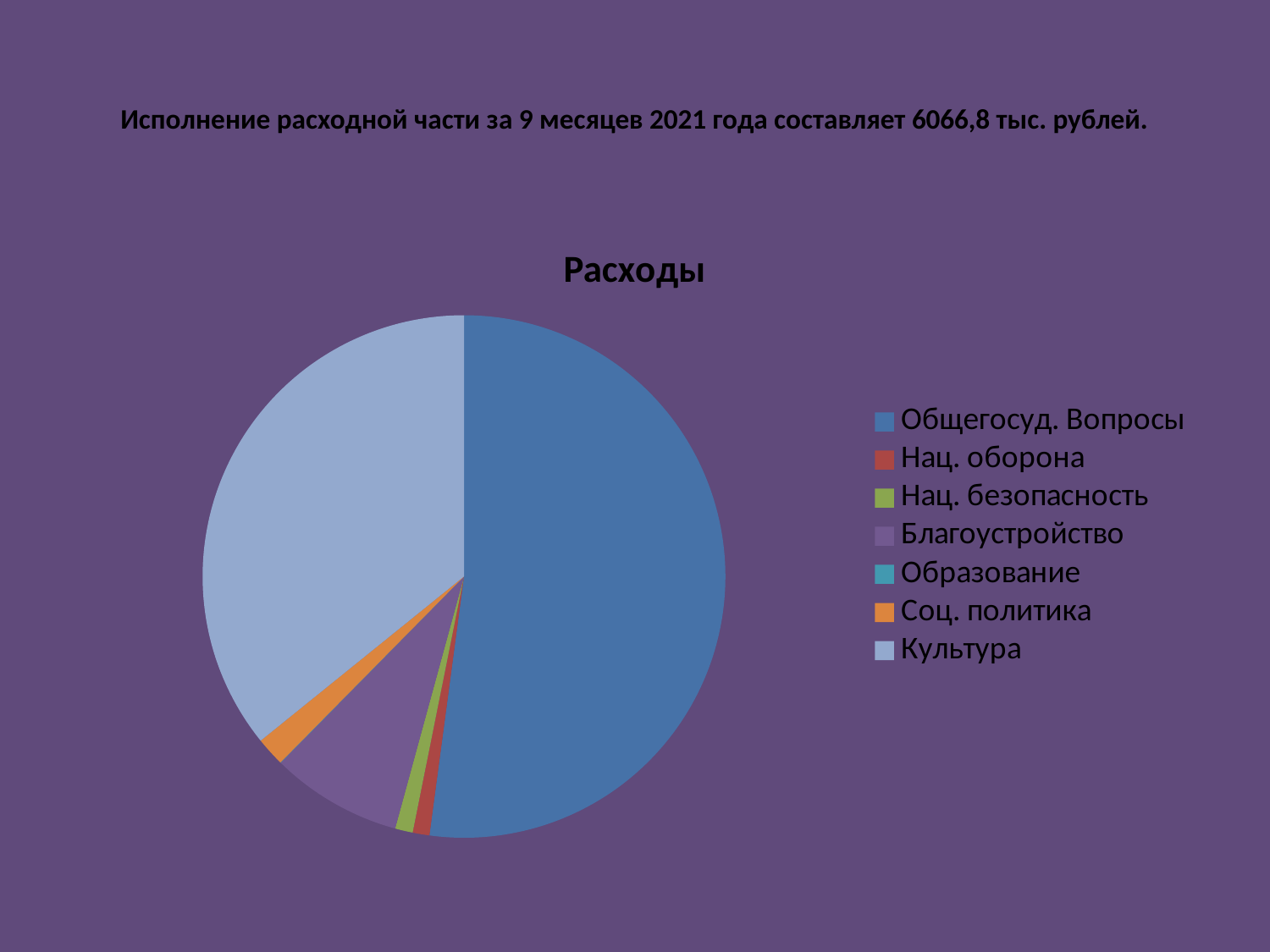
What is the title of the chart? Расходы Which slice is larger, Культура or Благоустройство? Культура How many categories does the legend of the chart list? 7 Which category has the second-largest slice in the pie chart? Культура What kind of chart is shown on the slide? pie chart Which slice is larger, Благоустройство or Соц. политика? Благоустройство Which category has the largest slice in the pie chart? Общегосуд. Вопросы What colour is the slice for Культура in the pie chart? light blue Which slice is larger, Соц. политика or Нац. оборона? Соц. политика